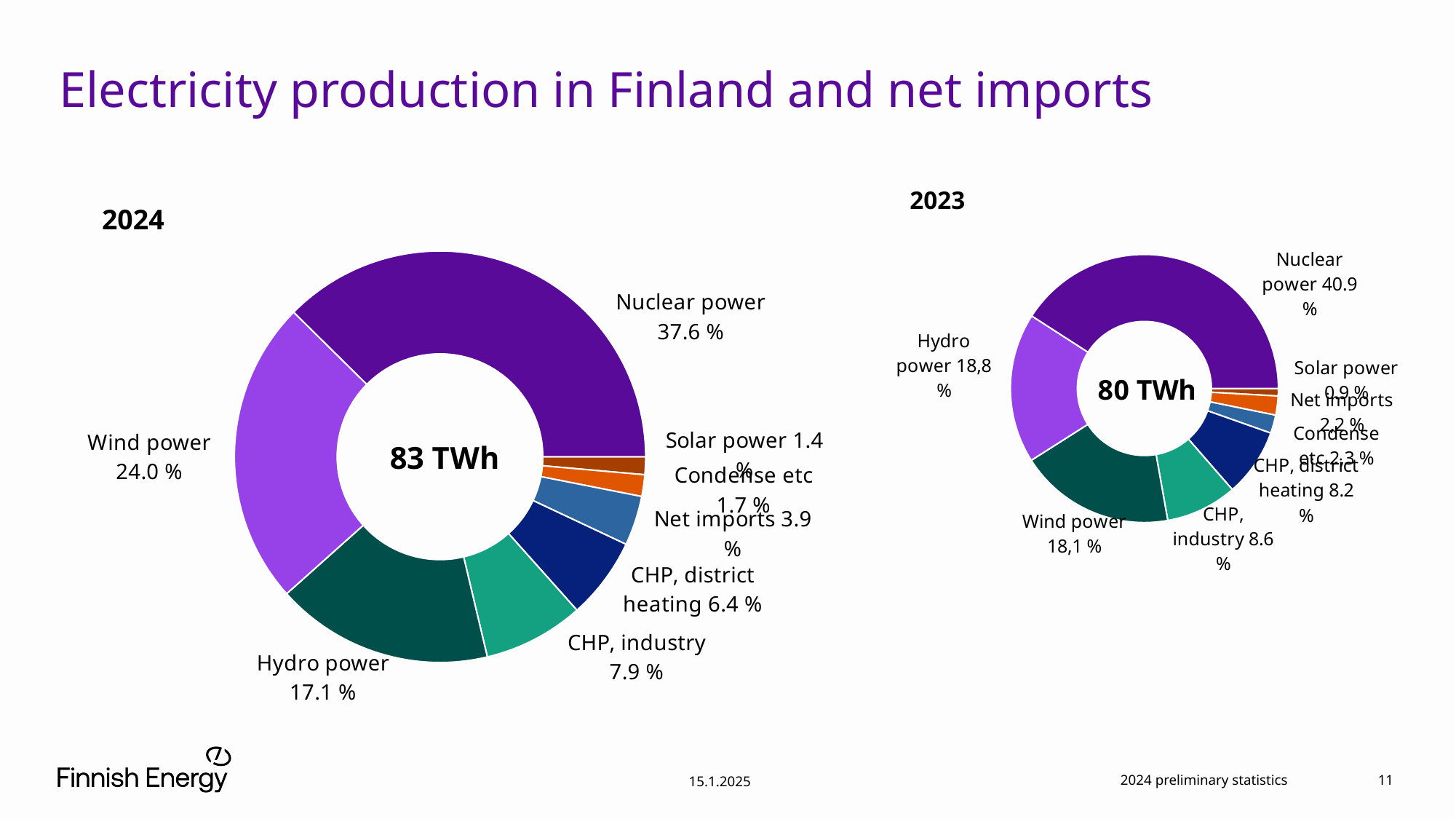
On the 2023 chart, which is larger, Hydro power or Wind power? Hydro power On the 2023 chart, what share does Nuclear power have? 40.9 % On the 2024 chart, what is the difference in percentage points between Wind power and Hydro power? 6.9 On the 2024 chart, what share does Nuclear power have? 37.6 % On the 2024 chart, what share does Wind power have? 24.0 % On the 2024 chart, how many categories are shown? 8 What kind of chart is the 2024 chart? Pie (donut) chart What total is printed in the centre of the 2024 chart? 83 TWh On the 2023 chart, what share does CHP, industry have? 8.6 % On the 2024 chart, which category has the smallest share? Solar power What total is printed in the centre of the 2023 chart? 80 TWh On the 2024 chart, which category has the largest share? Nuclear power